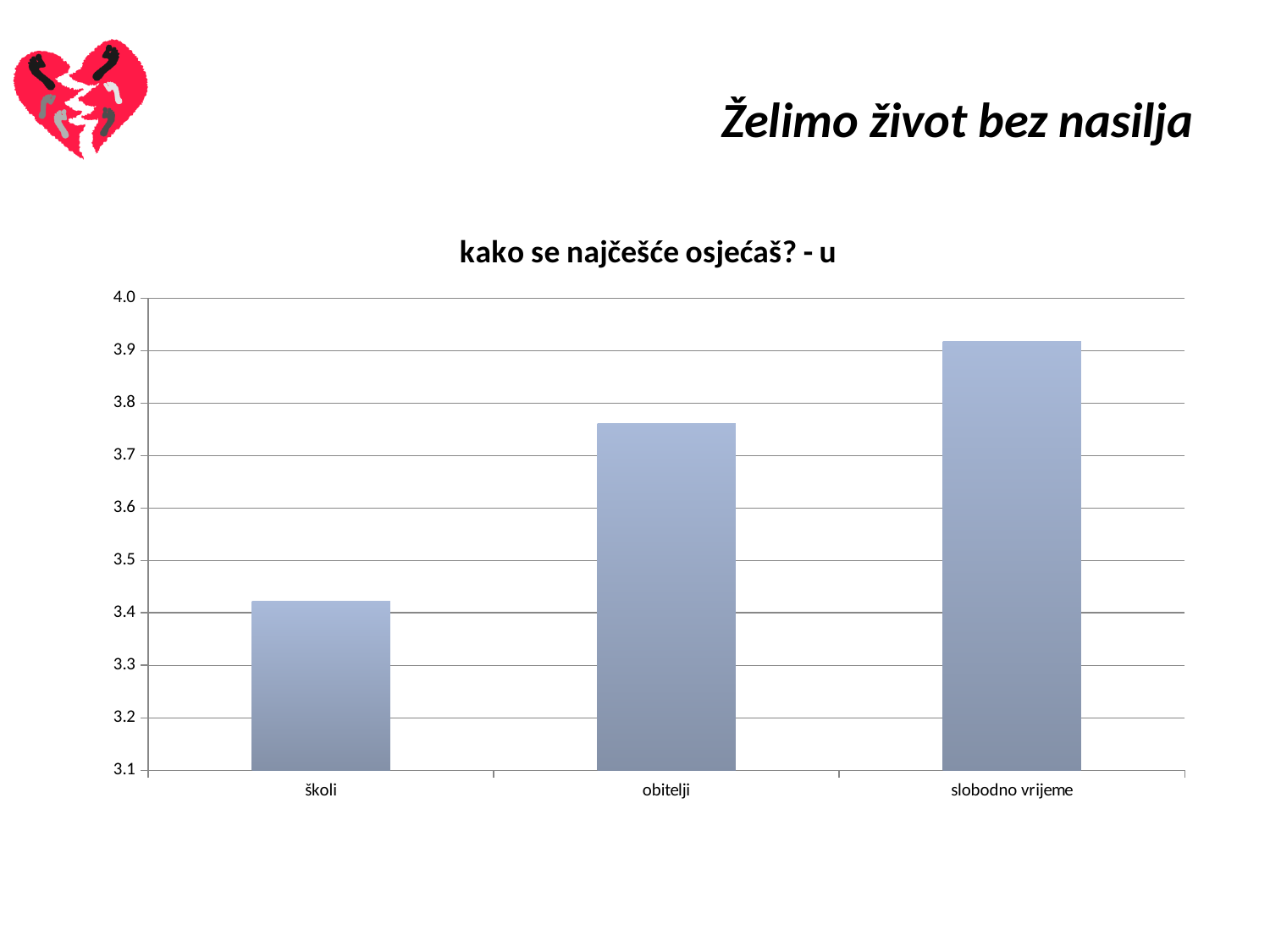
Is the value for školi greater or less than 3.5? less How many categories are shown on the x axis of the chart? 3 Which category has the lowest value? školi Which is larger, the value for slobodno vrijeme or the value for obitelji? slobodno vrijeme Is the value for obitelji greater or less than 3.7? greater Which is larger, the value for obitelji or the value for školi? obitelji Which category has the highest value? slobodno vrijeme What kind of chart is shown on the slide? bar chart What is the title of the chart? kako se najčešće osjećaš? - u Is the value for slobodno vrijeme greater or less than 3.8? greater Do the values rise or fall from left to right along the x axis? rise